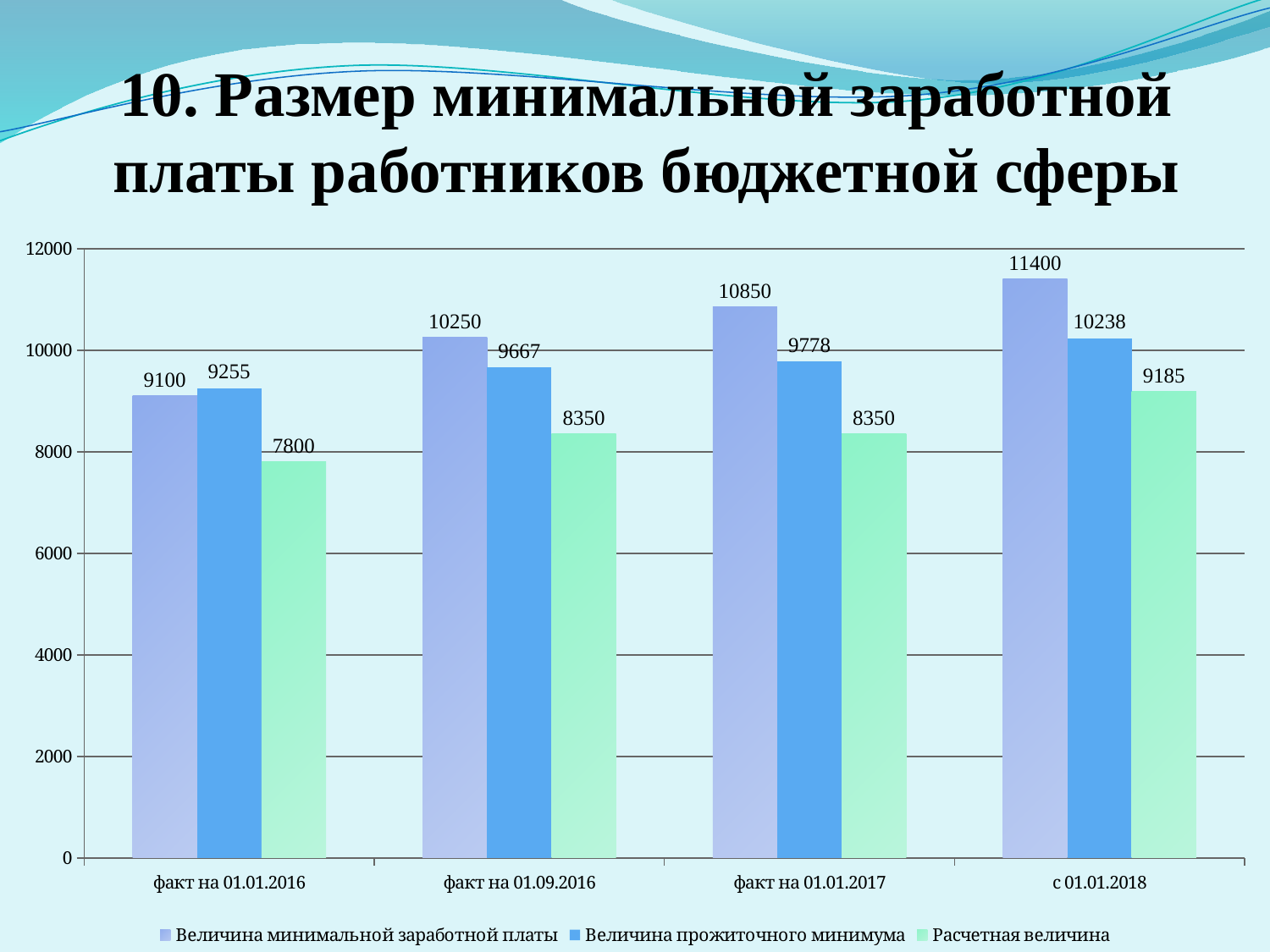
For факт на 01.01.2016, which is larger: Величина минимальной заработной платы or Величина прожиточного минимума? Величина прожиточного минимума Which category has the highest value for Величина минимальной заработной платы? с 01.01.2018 Does Величина минимальной заработной платы rise or fall across the categories from left to right? rise What is the value of Величина прожиточного минимума for факт на 01.09.2016? 9667 What is the value of Расчетная величина for с 01.01.2018? 9185 Is the value of Величина минимальной заработной платы for факт на 01.01.2017 greater or less than 10000? greater How many series does the legend list? 3 How many categories are shown on the x axis? 4 What is the value of Величина минимальной заработной платы for факт на 01.01.2016? 9100 What kind of chart is shown on the slide? bar chart Which category has the lowest value for Расчетная величина? факт на 01.01.2016 What is the difference between Величина минимальной заработной платы and Величина прожиточного минимума for с 01.01.2018? 1162